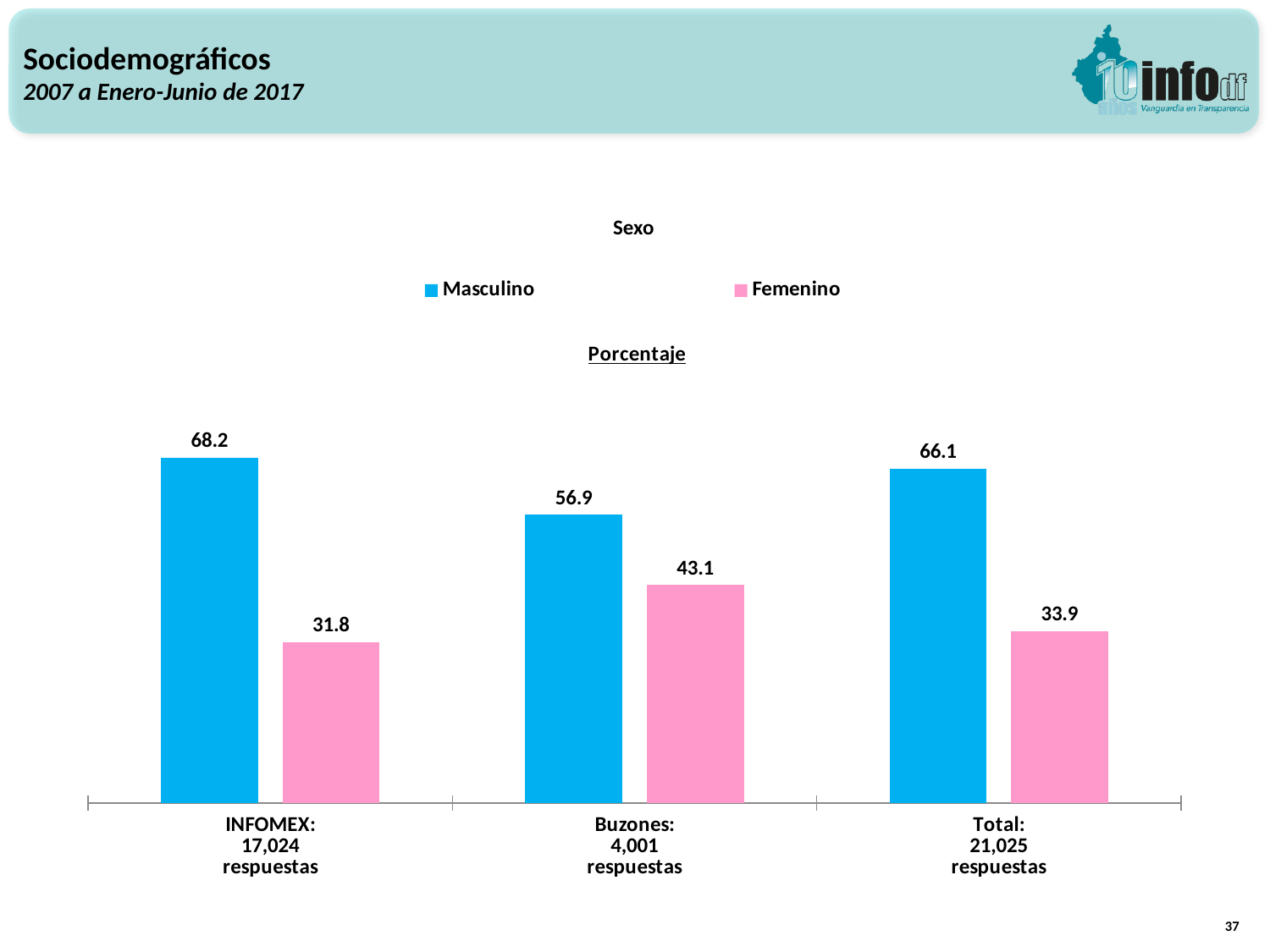
How many categories are shown on the x axis? 3 What is the Masculino value for INFOMEX? 68.2 What is the difference between the Masculino values for INFOMEX and Buzones? 11.3 What kind of chart is shown on the slide? Bar chart Which category has the highest Masculino value? INFOMEX What is the Femenino value for Total? 33.9 How many series does the legend list? 2 What is the difference between the Masculino and Femenino values for Total? 32.2 Which category has the lowest Femenino value? INFOMEX What is the Masculino value for Buzones? 56.9 What is the Femenino value for Buzones? 43.1 Which is larger, the Femenino value for Buzones or the Femenino value for Total? Buzones